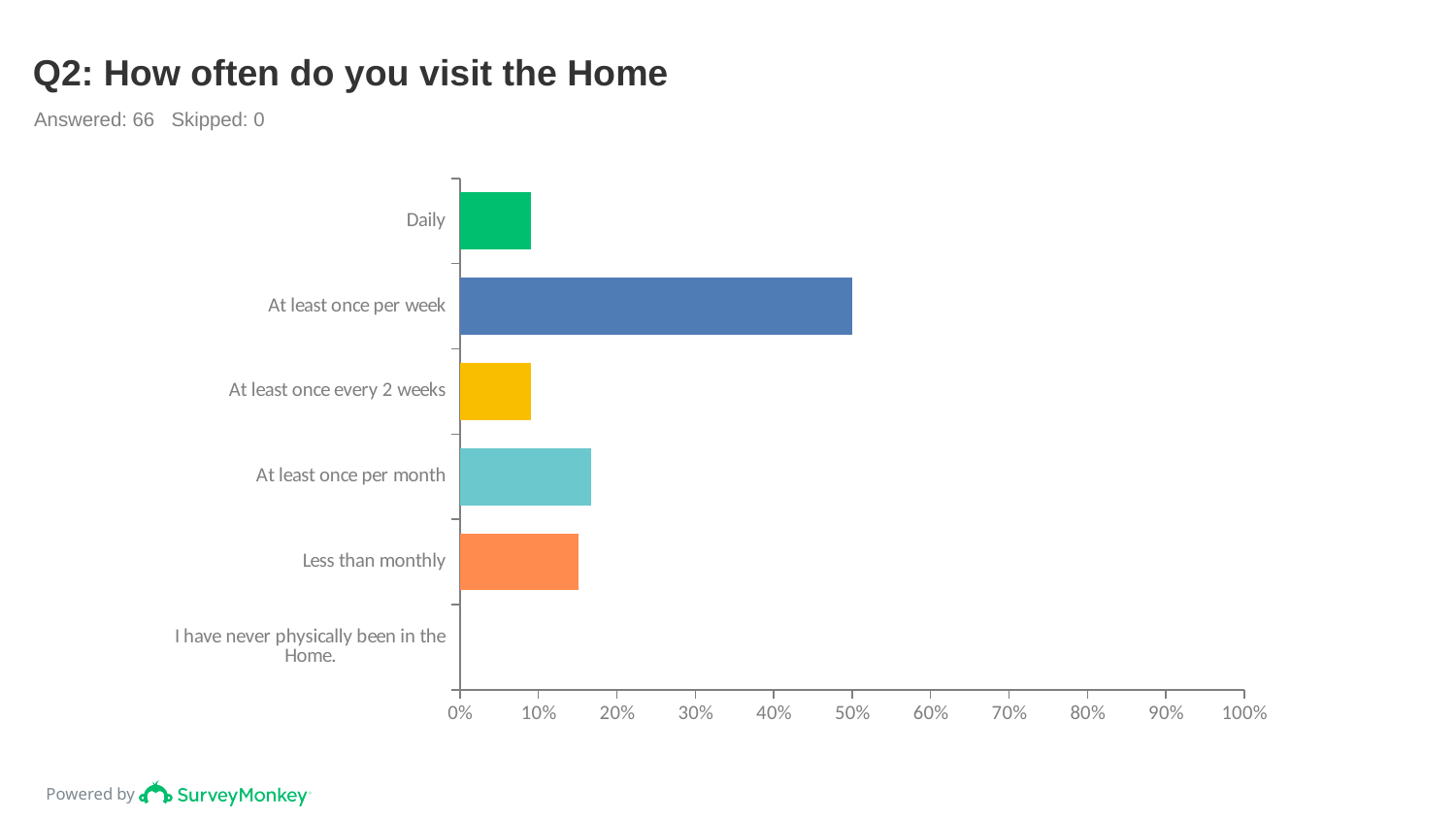
Is the value for 'At least once per month' greater or less than 20%? less How many categories are shown on the chart? 6 Is the value for 'At least once per month' greater or less than 10%? greater Is the value for 'Less than monthly' greater or less than 10%? greater What kind of chart is shown on the slide? Bar chart What is the value for 'At least once per week'? 50% Which category has the lowest value? I have never physically been in the Home. What is the title of the chart? Q2: How often do you visit the Home Which is larger, the value for 'At least once per week' or the value for 'At least once per month'? At least once per week How many respondents answered the question according to the slide? 66 Which category has the highest value? At least once per week